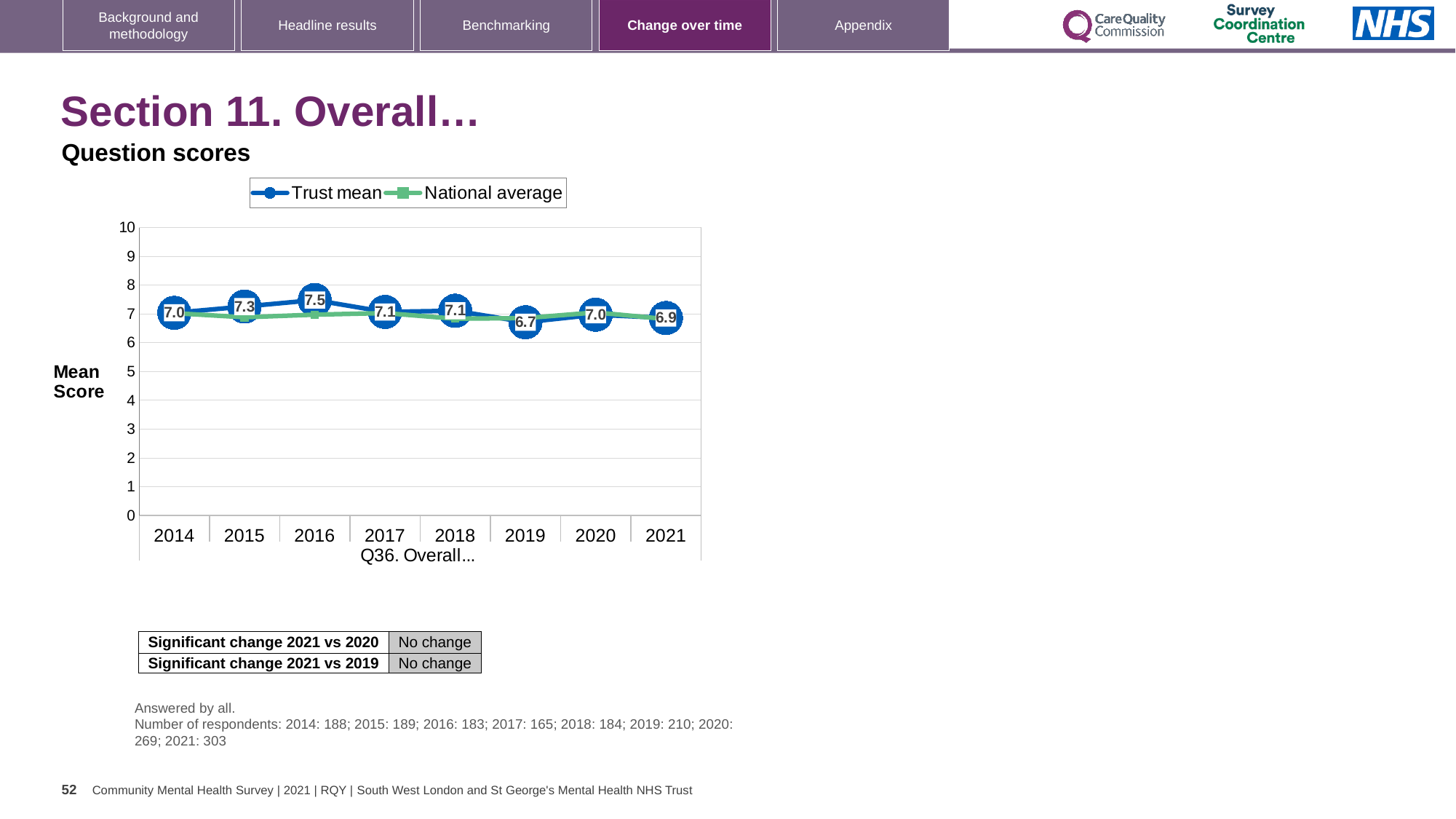
What is the Trust mean score for 2016? 7.5 What is the label on the y axis of the chart? Mean Score What is the difference between the Trust mean in 2016 and in 2019? 0.8 Is the National average value for 2018 greater or less than 5? greater In which year is the Trust mean highest? 2016 What kind of chart is shown on the slide? Line chart In which year is the Trust mean lowest? 2019 What is the Trust mean score for 2021? 6.9 What is the Trust mean score for 2019? 6.7 How many series does the legend list? 2 How many years are shown on the x axis? 8 Which year has the larger Trust mean, 2015 or 2020? 2015